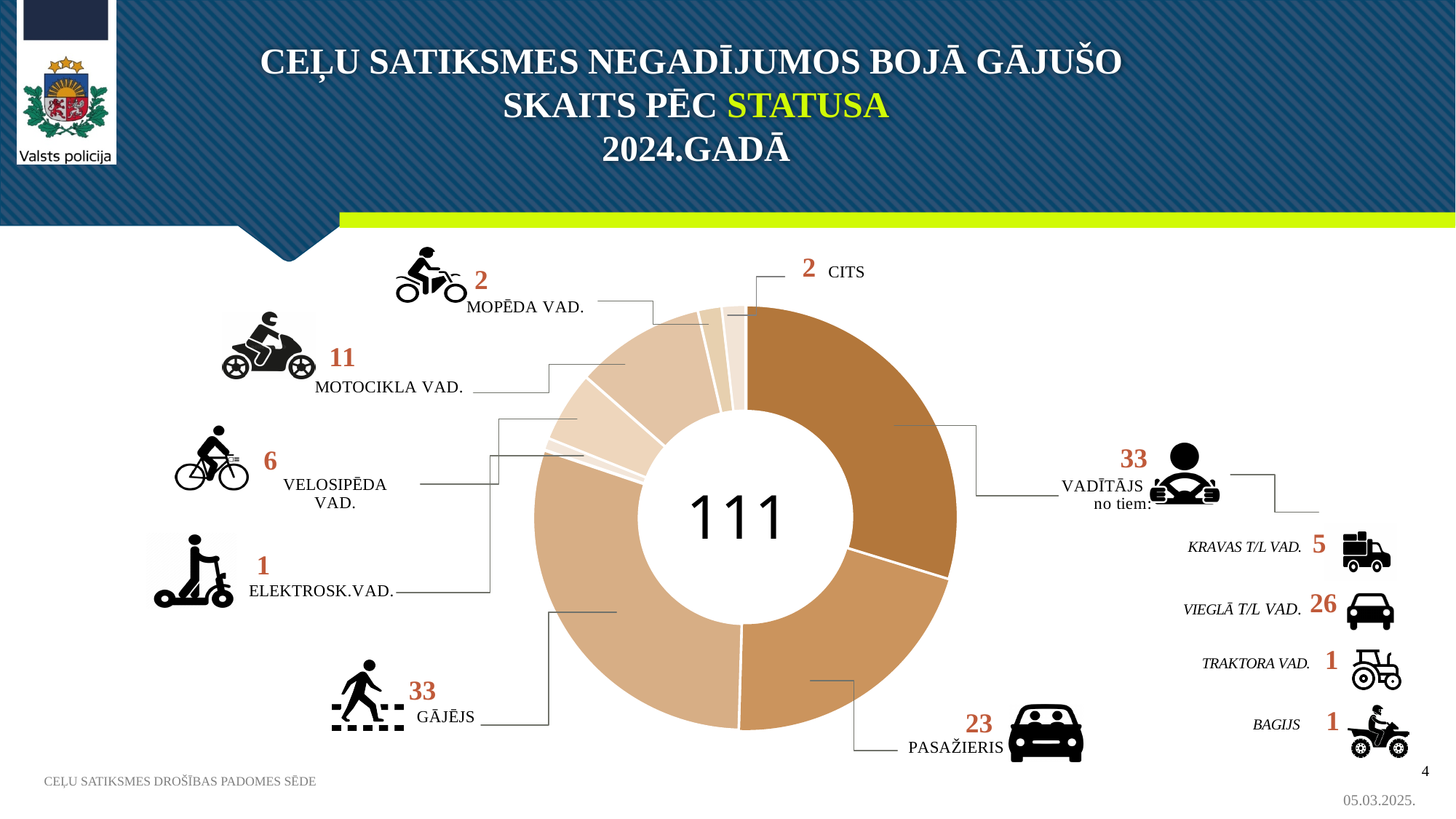
What is the value shown for VELOSIPĒDA VAD.? 6 How many status categories (slices) does the donut chart show? 8 What is the value shown for PASAŽIERIS? 23 What is the difference between the values for MOPĒDA VAD. and CITS? 0 How many people with the status GĀJĒJS died in road traffic accidents in 2024 according to the chart? 33 Of the 33 VADĪTĀJS, how many were VIEGLĀ T/L VAD.? 26 What kind of chart is shown on the slide? Donut (pie) chart Which is larger, the value for MOTOCIKLA VAD. or the value for VELOSIPĒDA VAD.? MOTOCIKLA VAD. What is the value shown for MOTOCIKLA VAD.? 11 What total number is printed in the centre of the donut chart? 111 Which status category has the smallest value on the chart? ELEKTROSK.VAD. What is the difference between the values for VADĪTĀJS and PASAŽIERIS? 10